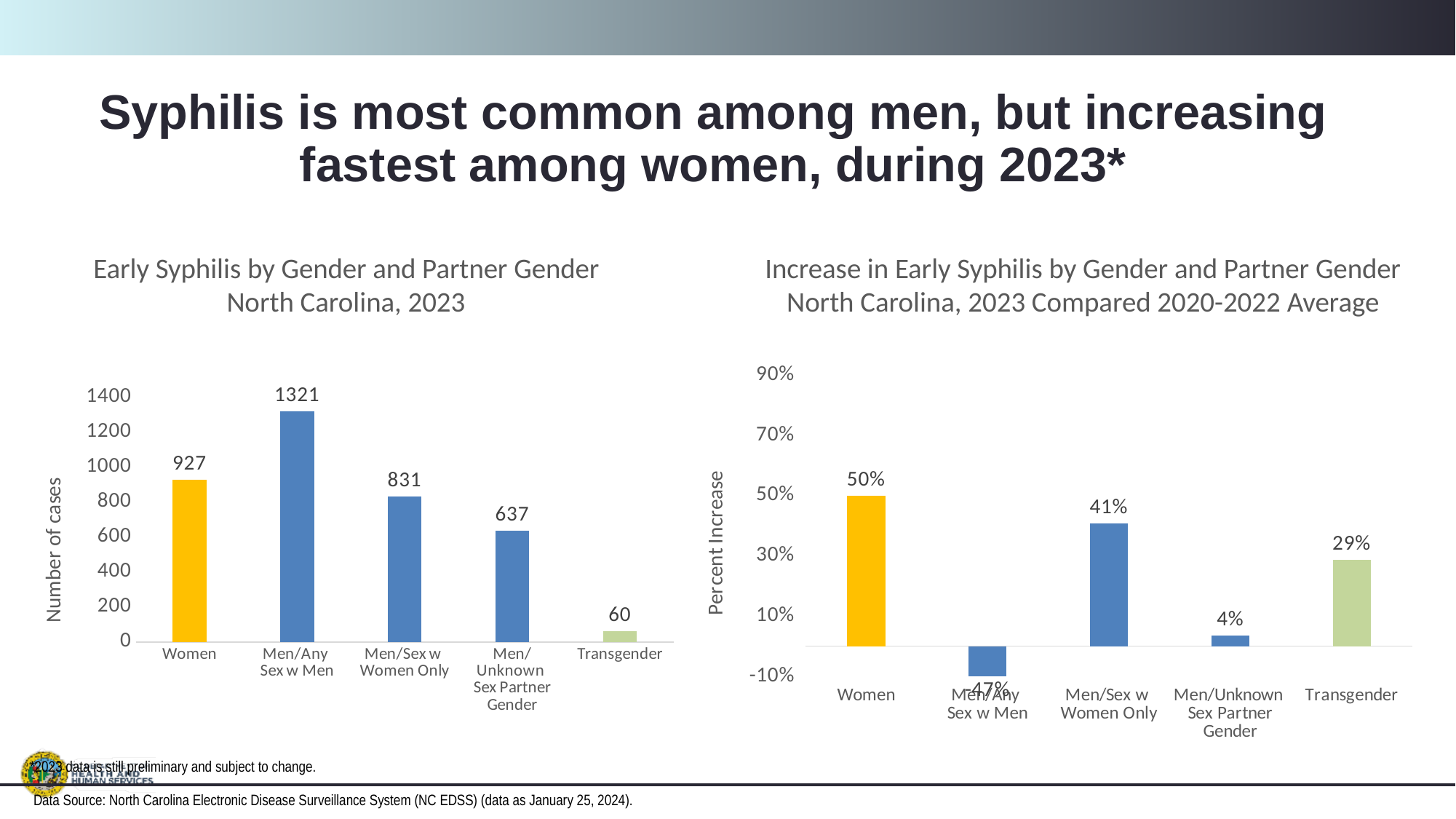
In the right chart (Increase in Early Syphilis by Gender and Partner Gender), what is the percent increase for Women? 50% In the left chart (Early Syphilis by Gender and Partner Gender), which category has the highest number of cases? Men/Any Sex w Men What type of chart is the left chart (Early Syphilis by Gender and Partner Gender)? Bar chart In the right chart (Increase in Early Syphilis by Gender and Partner Gender), which is larger: the value for Men/Sex w Women Only or the value for Men/Unknown Sex Partner Gender? Men/Sex w Women Only In the left chart (Early Syphilis by Gender and Partner Gender), how many cases are shown for Men/Unknown Sex Partner Gender? 637 In the right chart (Increase in Early Syphilis by Gender and Partner Gender), which category has the highest percent increase? Women In the right chart (Increase in Early Syphilis by Gender and Partner Gender), what is the percent increase for Transgender? 29% In the left chart (Early Syphilis by Gender and Partner Gender), how many categories are plotted? 5 In the left chart (Early Syphilis by Gender and Partner Gender), which category has the lowest number of cases? Transgender In the right chart (Increase in Early Syphilis by Gender and Partner Gender), which category has the lowest value? Men/Any Sex w Men In the left chart (Early Syphilis by Gender and Partner Gender, North Carolina, 2023), how many cases are shown for Women? 927 In the left chart (Early Syphilis by Gender and Partner Gender), what is the difference in cases between Men/Any Sex w Men and Women? 394